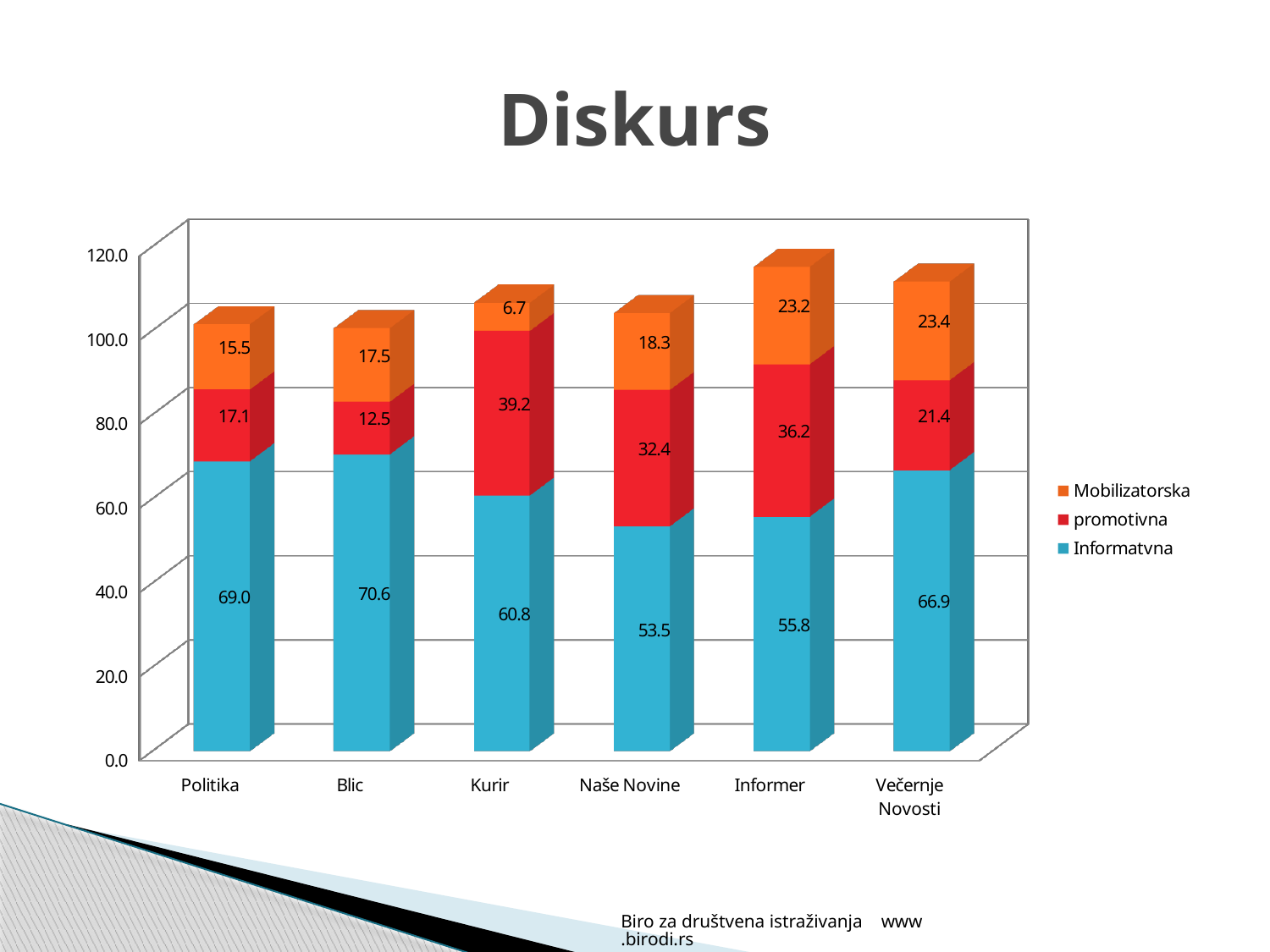
Which is larger, the Informatvna value for Politika or for Naše Novine? Politika What is the title of the chart? Diskurs What is the promotivna value for Kurir? 39.2 What is the Mobilizatorska value for Informer? 23.2 Which category has the highest Informatvna value? Blic What is the total of the stacked bar for Informer? 115.2 How many series does the legend list? 3 What is the difference between the promotivna values for Informer and Blic? 23.7 How many categories are shown on the x axis? 6 What kind of chart is shown on the slide? Stacked bar chart What is the Informatvna value for Blic? 70.6 Which category has the lowest Mobilizatorska value? Kurir